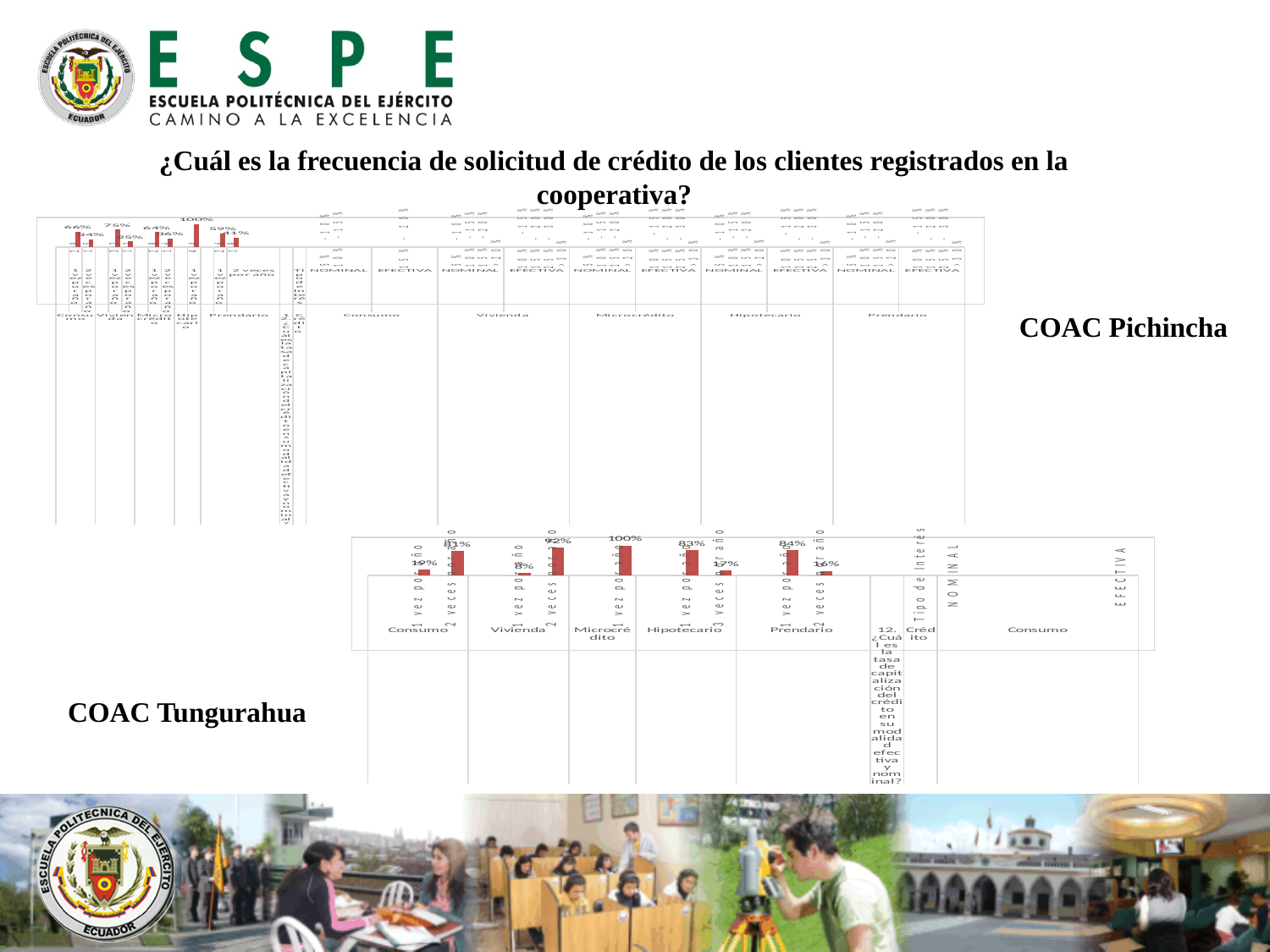
In the COAC Pichincha chart, what is the value for Prendario, 2 veces por año? 41% In the COAC Pichincha chart, what is the value shown for Hipotecario? 100% In the COAC Pichincha chart, what percentage of Consumo clients request credit 1 vez por año? 66% In the COAC Tungurahua chart, which is larger for Prendario: 1 vez por año or 2 veces por año? 1 vez por año What type of chart is used for COAC Tungurahua? Bar chart In the COAC Pichincha chart, which credit category has the highest bar? Hipotecario In the COAC Pichincha chart, what is the difference between the 1 vez por año and 2 veces por año values for Consumo? 32 percentage points In the COAC Pichincha chart, what is the value for Vivienda, 1 vez por año? 75% In the COAC Tungurahua chart, what is the value for Hipotecario, 1 vez por año? 83% In the COAC Tungurahua chart, what is the value shown for Microcrédito? 100% In the COAC Tungurahua chart, what is the value for Vivienda, 2 veces por año? 92% In the COAC Tungurahua chart, what is the value for Consumo, 2 veces por año? 81%